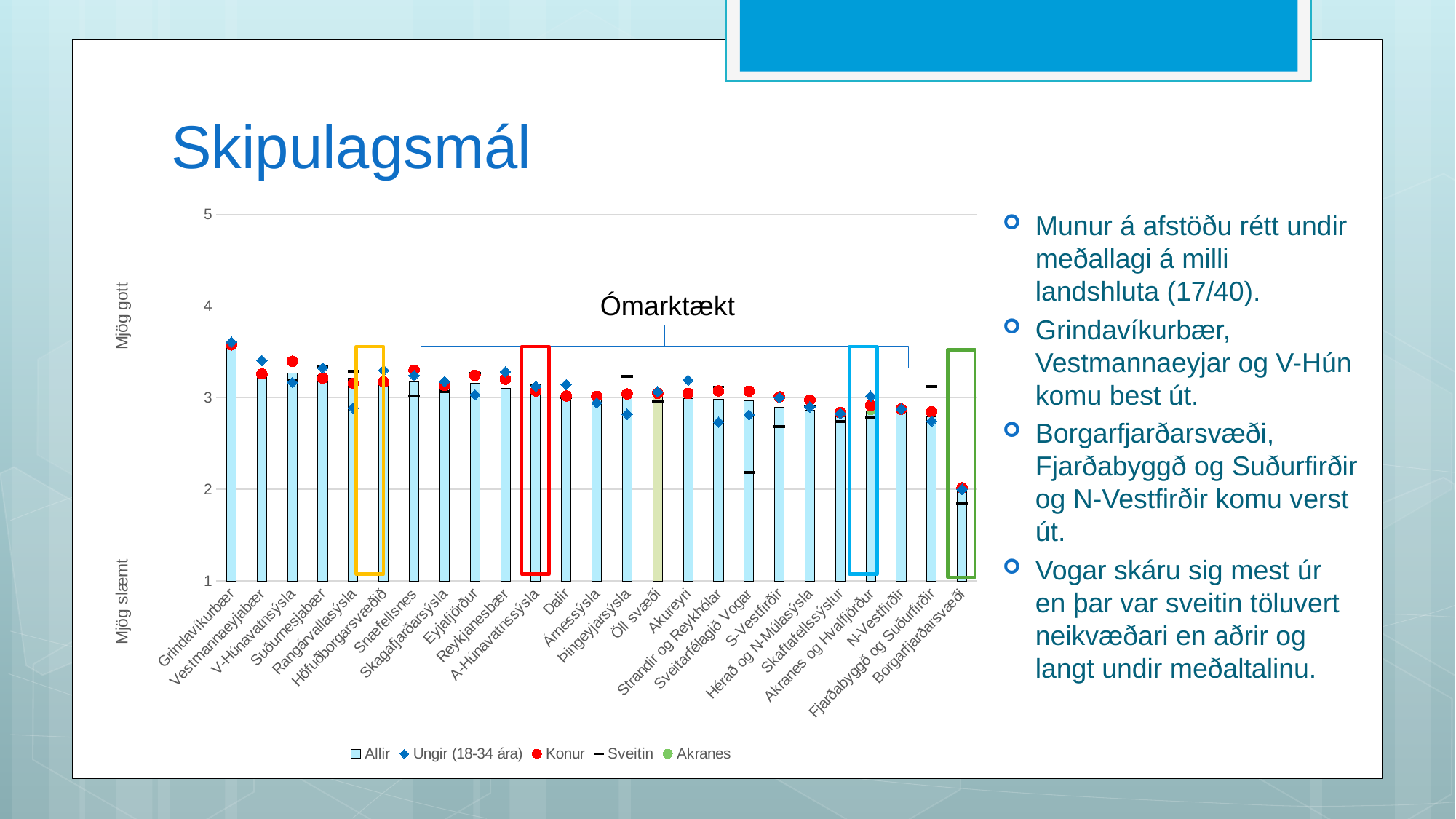
Which has the larger Allir value, Vestmannaeyjabær or Borgarfjarðarsvæði? Vestmannaeyjabær How many categories are shown along the x axis of the chart? 25 How many series does the chart legend list? 5 What kind of chart is shown on the slide? Bar chart Is the Allir value for Grindavíkurbær greater or less than 3? greater Which category has the lowest Allir bar? Borgarfjarðarsvæði Is the Sveitin value for Sveitarfélagið Vogar greater or less than 3? less Which category has the highest Allir bar? Grindavíkurbær Do the Allir bars generally rise or fall from left to right along the x axis? fall Is the Allir value for Borgarfjarðarsvæði greater or less than 3? less What annotation text is written above the bracketed group of bars in the middle of the chart? Ómarktækt Which series in the legend is shown with red circle markers? Konur